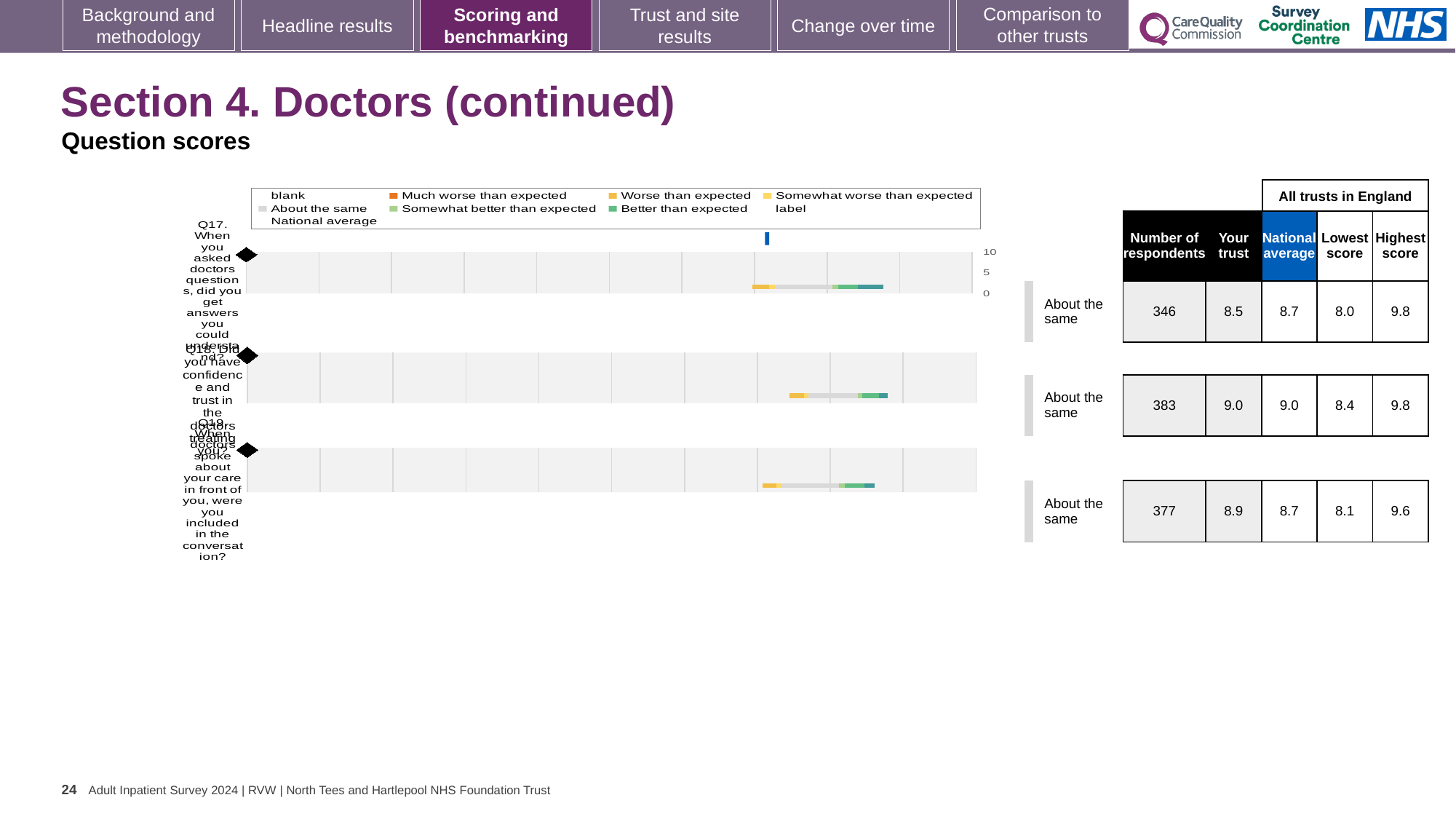
In the table beside the chart, what is the 'Your trust' score for Q18? 9.0 In the table beside the chart, is the 'Your trust' score for Q17 larger or smaller than the national average for Q17? smaller How many entries does the chart legend list? 9 Which legend entry is shown in orange in the chart? Much worse than expected In the table beside the chart, which question has the highest 'Your trust' score? Q18 What kind of chart is shown on the slide? bar chart How many questions (categories) are plotted in the chart? 3 What benchmark category is shown for Q17 next to the chart? About the same What is the highest value shown on the chart's axis? 10 In the table beside the chart, what is the national average for Q17? 8.7 In the table beside the chart, what is the difference between the highest score and the lowest score for Q19? 1.5 What benchmark category is shown for Q19 next to the chart? About the same